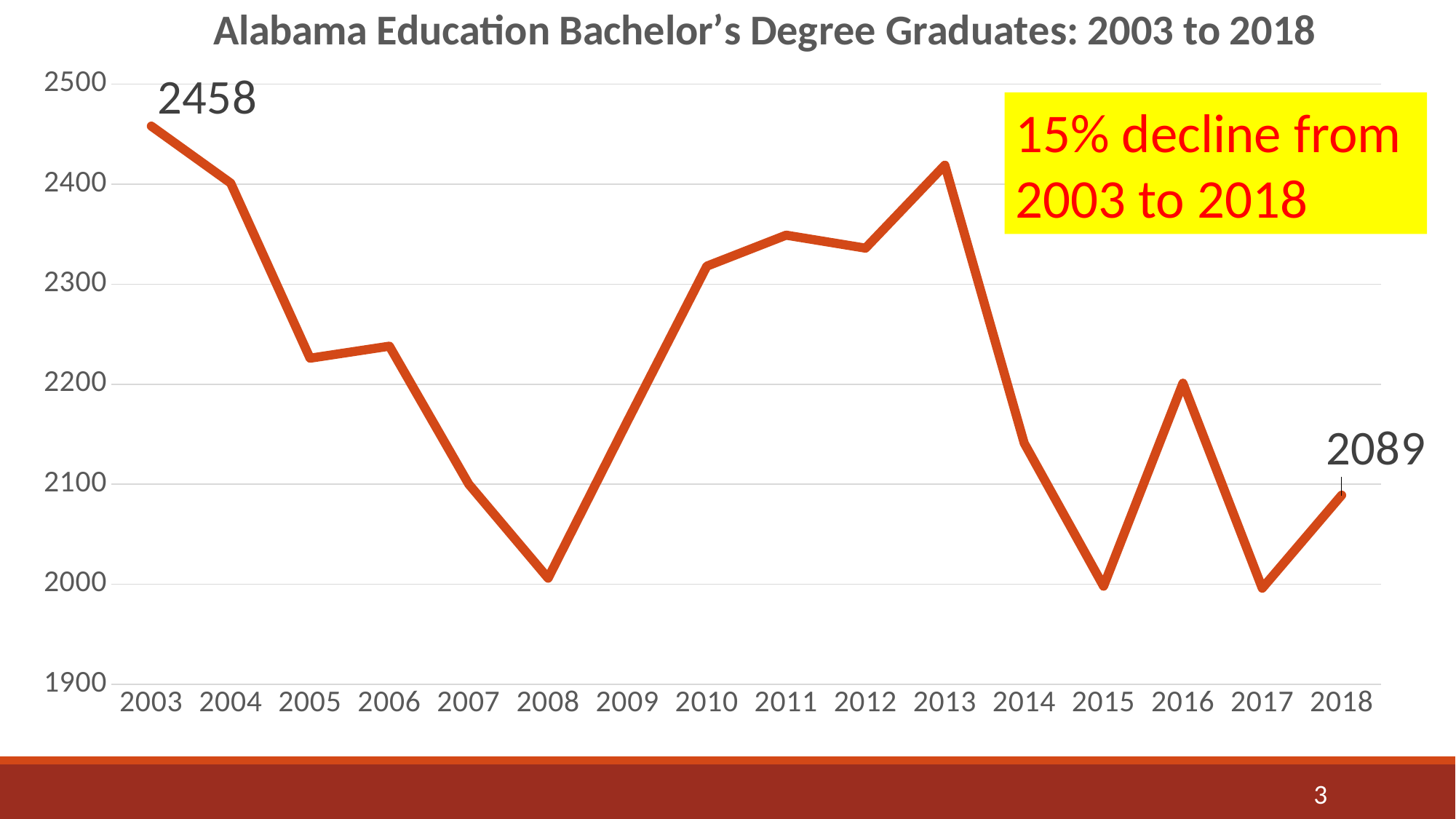
Which year has the highest value on the chart? 2003 Is the value for 2016 greater or less than 2100? greater What is the title of the chart? Alabama Education Bachelor's Degree Graduates: 2003 to 2018 What is the value for 2003? 2458 What is the difference between the 2003 value and the 2018 value? 369 Is the value for 2008 greater or less than 2100? less What type of chart is shown on the slide? line chart What does the yellow annotation box on the chart say? 15% decline from 2003 to 2018 Is the value for 2011 greater or less than 2300? greater How many years are plotted on the x axis? 16 What is the value for 2018? 2089 Which is larger, the value for 2003 or the value for 2018? 2003